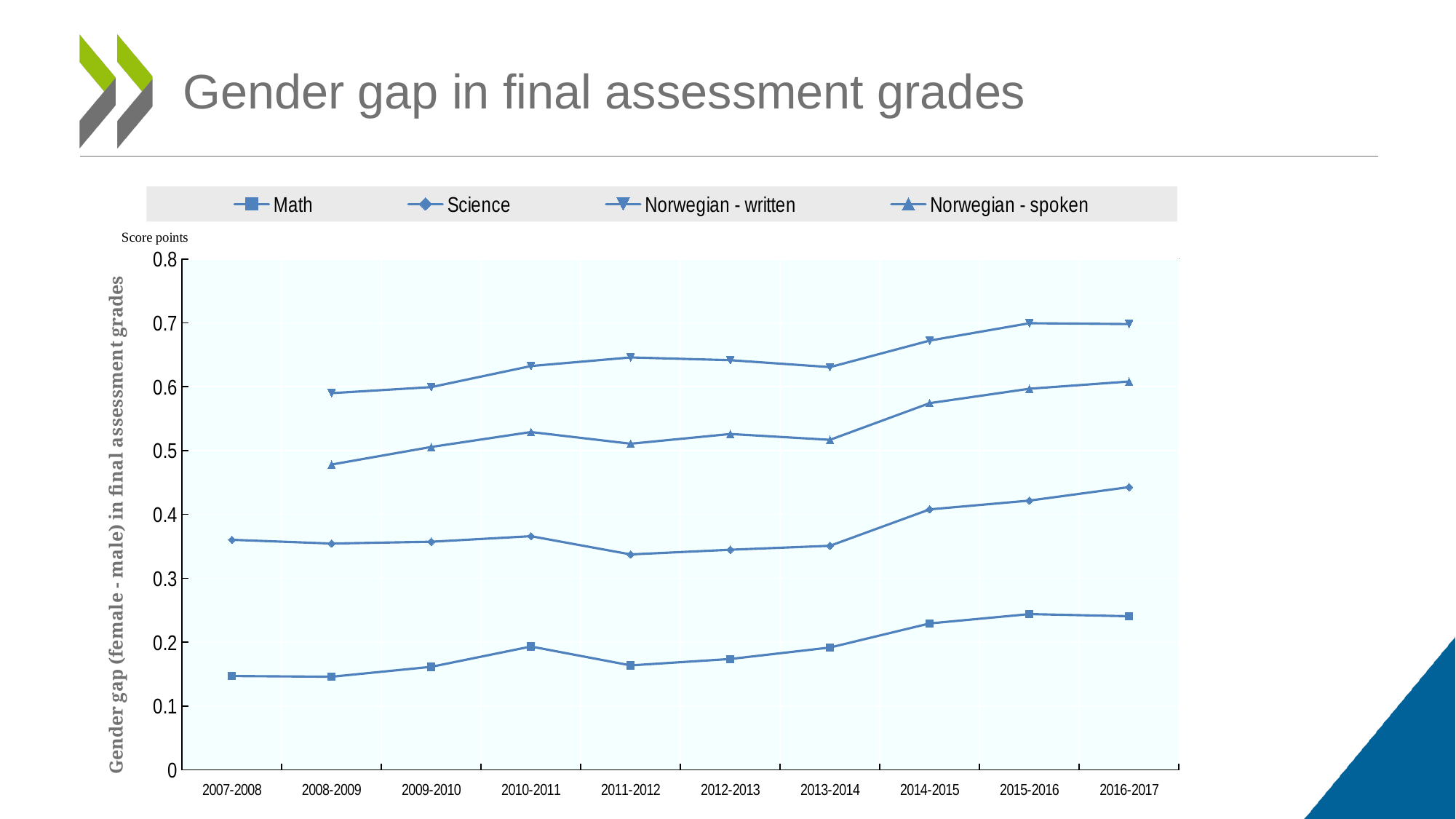
What is the title of the vertical axis? Gender gap (female - male) in final assessment grades Is the value for Math in 2016-2017 greater or less than 0.3? less Is the value for Norwegian - spoken in 2008-2009 greater or less than 0.5? less What kind of chart is shown on the slide? line chart How many series does the legend list? 4 In 2014-2015, which is larger: the value for Norwegian - spoken or the value for Science? Norwegian - spoken Does the Math series rise or fall from 2013-2014 to 2015-2016? rise How many school years are shown on the x axis? 10 Which series has the highest values across the chart? Norwegian - written In which school year does the Science series reach its highest value? 2016-2017 Is the value for Norwegian - written in 2015-2016 greater or less than 0.6? greater Which series has the lowest values across the chart? Math